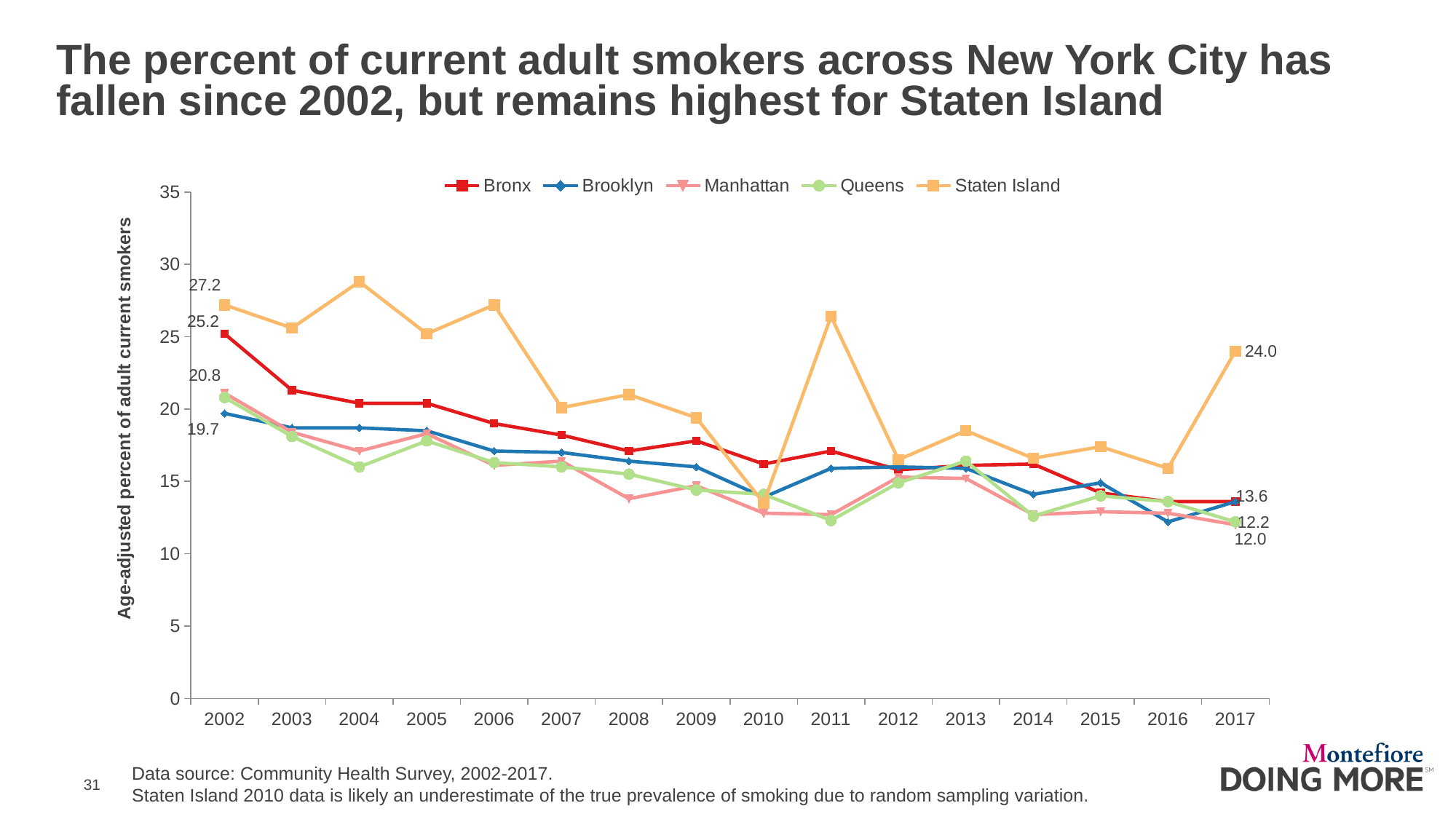
What kind of chart is shown on the slide? Line chart Which borough had the highest percent of adult current smokers in 2017? Staten Island What was the age-adjusted percent of adult current smokers in the Bronx in 2002? 25.2 How many series does the legend list? 5 What was the age-adjusted percent of adult current smokers in Brooklyn in 2002? 19.7 What was the age-adjusted percent of adult current smokers in Staten Island in 2002? 27.2 How many years are shown on the x axis? 16 Is the Staten Island value for 2004 greater or less than 25? greater By how much did the Staten Island value fall from 2002 to 2017? 3.2 What was the age-adjusted percent of adult current smokers in Staten Island in 2017? 24.0 What was the age-adjusted percent of adult current smokers in Manhattan in 2017? 12.0 What is the difference between the Bronx and Brooklyn values in 2002? 5.5